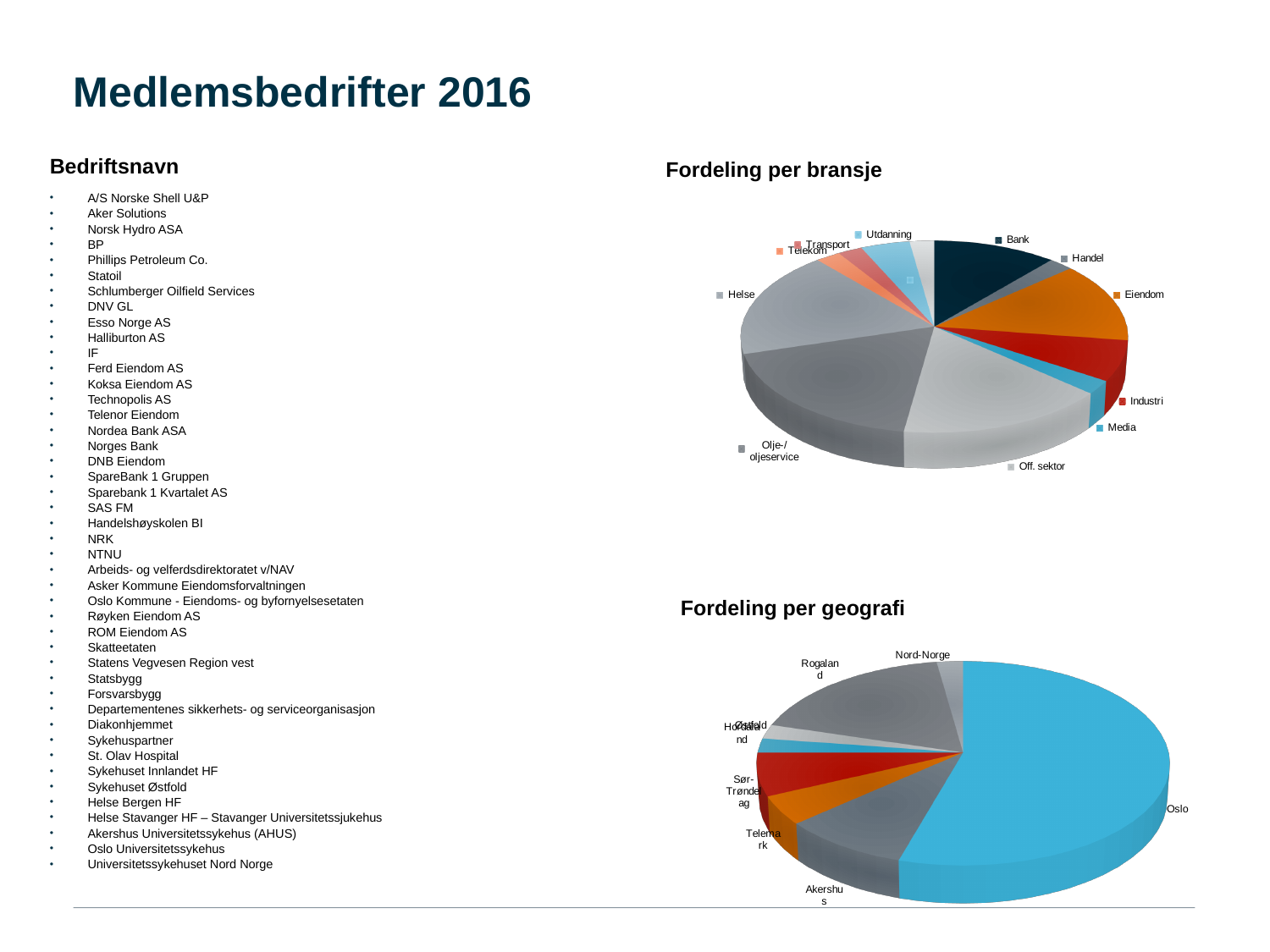
In the "Fordeling per bransje" chart, which slice is larger, Eiendom or Utdanning? Eiendom In the "Fordeling per bransje" chart, which slice is larger, Olje-/oljeservice or Media? Olje-/oljeservice In the "Fordeling per geografi" chart, which slice is larger, Oslo or Akershus? Oslo In the "Fordeling per geografi" chart, which region has the largest slice? Oslo What is the title of the lower pie chart on the slide? Fordeling per geografi How many categories are shown in the "Fordeling per bransje" pie chart? 12 What kind of chart is "Fordeling per geografi"? Pie chart What is the title of the upper pie chart on the slide? Fordeling per bransje What kind of chart is "Fordeling per bransje"? Pie chart How many categories are shown in the "Fordeling per geografi" pie chart? 8